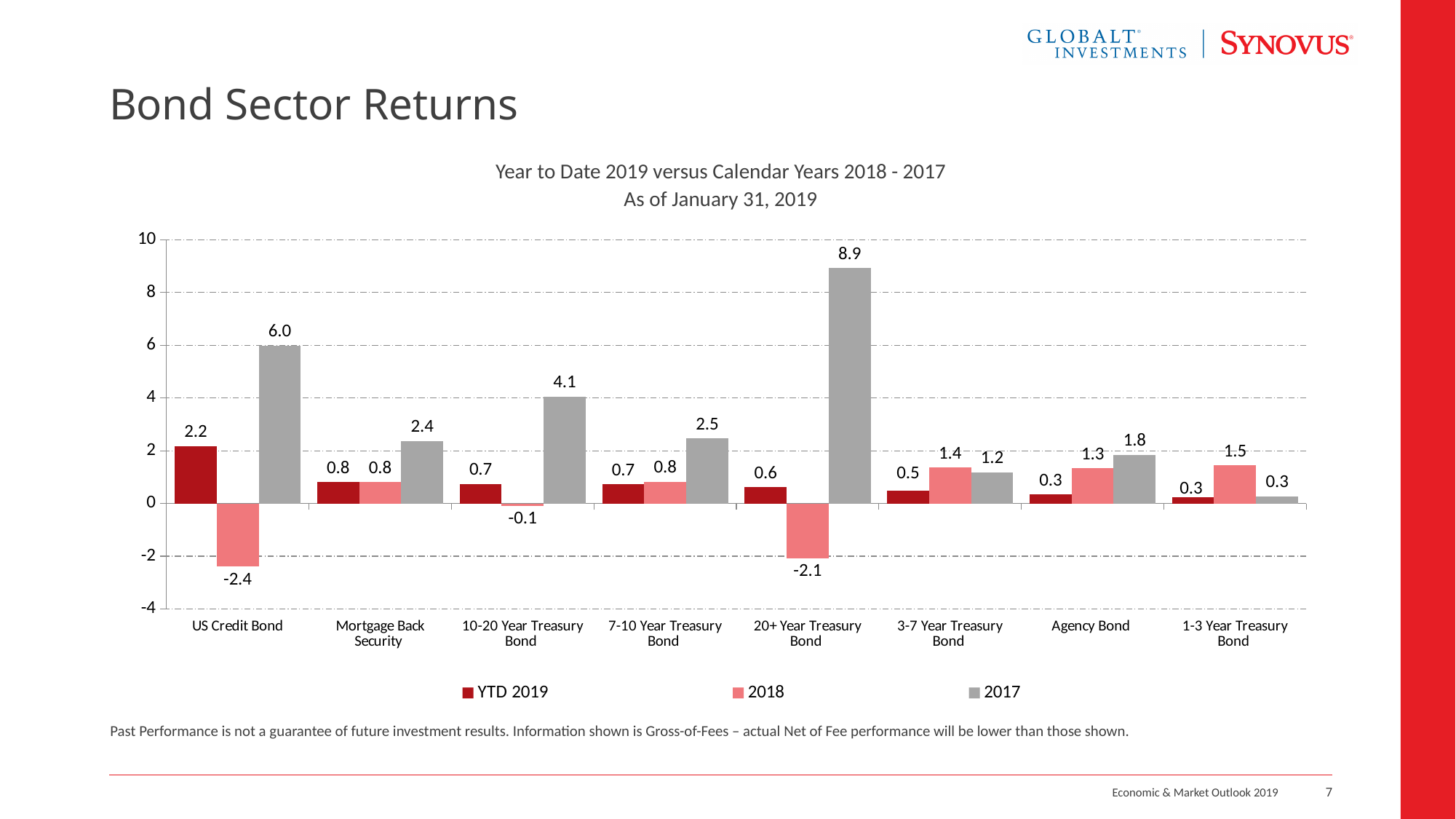
How many series does the legend list? 3 What is the 2018 value for US Credit Bond? -2.4 What kind of chart is shown on the slide? Bar chart What is the 2017 value for 20+ Year Treasury Bond? 8.9 What is the difference between the 2017 values for US Credit Bond and 10-20 Year Treasury Bond? 1.9 What is the subtitle date shown above the chart? As of January 31, 2019 Which is larger for 3-7 Year Treasury Bond: the 2018 value or the 2017 value? 2018 Which category has the lowest 2018 value? US Credit Bond What is the YTD 2019 value for Mortgage Back Security? 0.8 Which category has the highest 2017 value? 20+ Year Treasury Bond Which category has the highest YTD 2019 value? US Credit Bond How many bond categories are shown on the x axis? 8